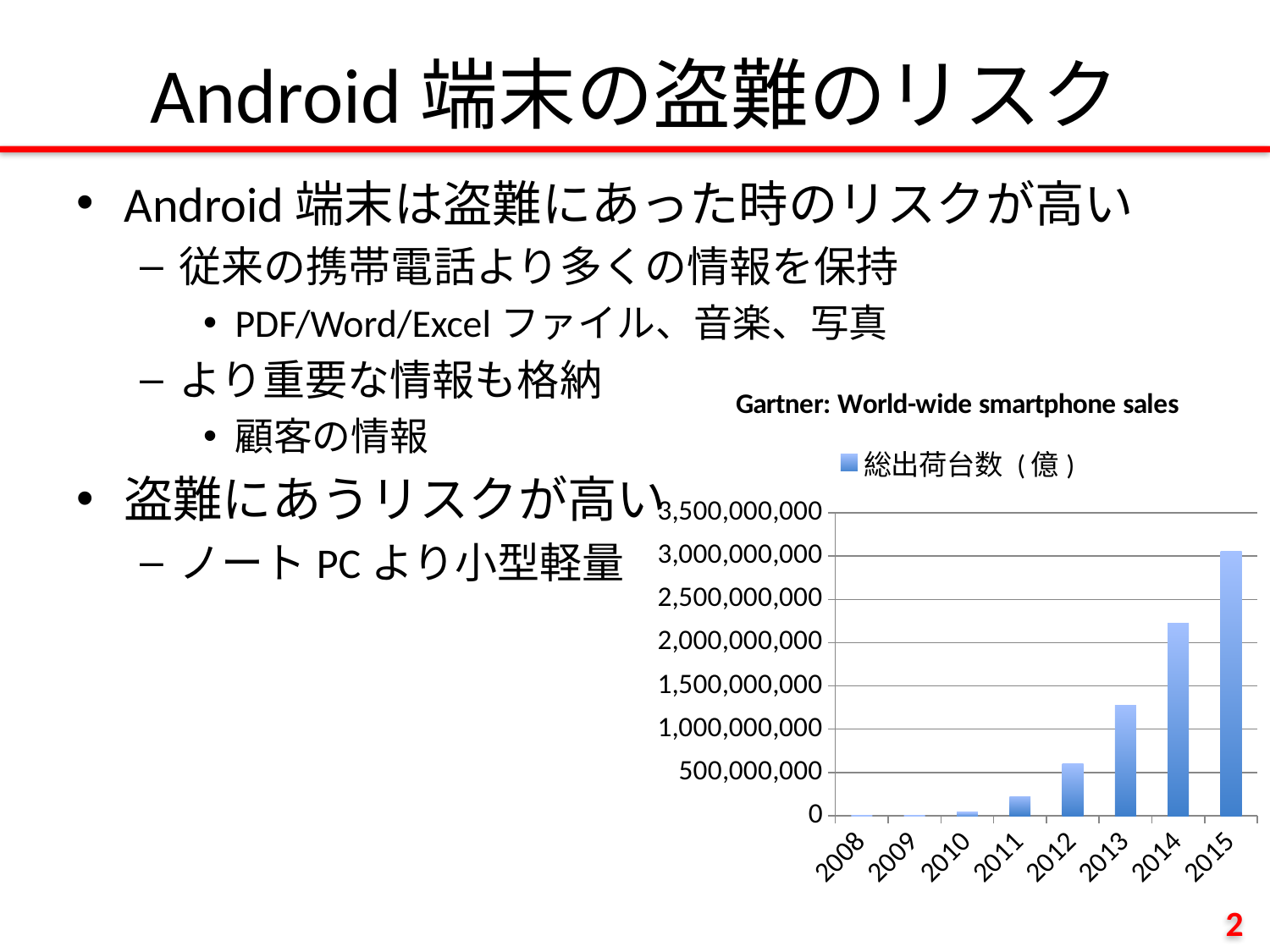
Do the values in the chart rise or fall from 2008 to 2015? rise Is the value for 2015 greater or less than 2,500,000,000? greater What series name does the chart legend show? 総出荷台数（億） Is the value for 2011 greater or less than 500,000,000? less Which year has the larger value, 2013 or 2014? 2014 What is the title of the chart on the slide? Gartner: World-wide smartphone sales How many series does the chart legend list? 1 Is the value for 2014 greater or less than 2,000,000,000? greater How many years are shown on the x axis of the chart? 8 What kind of chart is shown on the slide? bar chart Which year has the highest bar in the chart? 2015